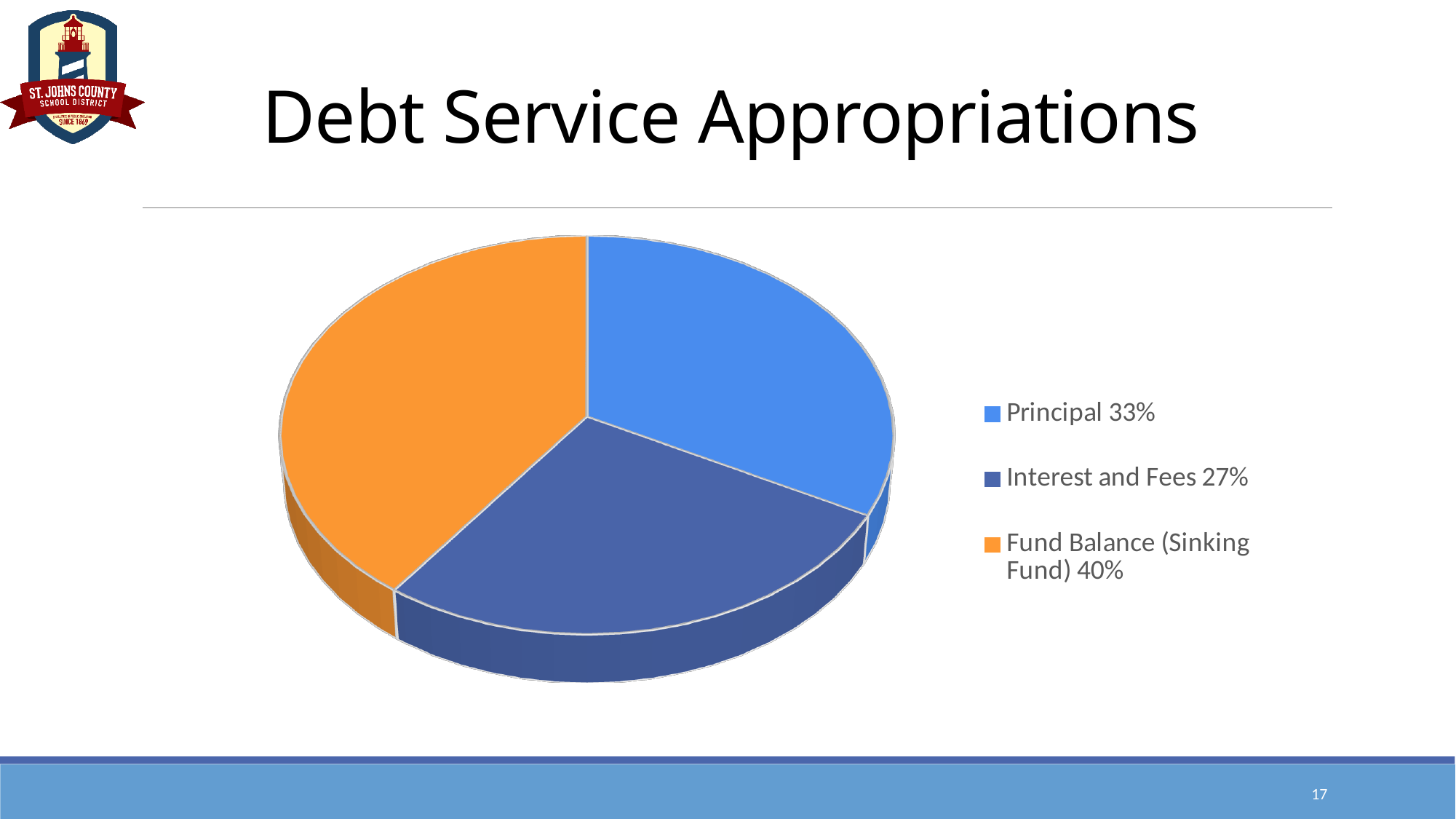
What is the difference in percentage points between Principal and Interest and Fees? 6 Which category has the smallest share of the pie? Interest and Fees What share of the pie is Principal? 33% What share of the pie is Fund Balance (Sinking Fund)? 40% How many categories does the pie chart show? 3 What colour is the Fund Balance (Sinking Fund) slice? Orange Which is larger, the share for Principal or the share for Interest and Fees? Principal What is the difference in percentage points between Fund Balance (Sinking Fund) and Principal? 7 What type of chart is shown on the slide? Pie chart Which category has the largest share of the pie? Fund Balance (Sinking Fund) What is the title of the chart? Debt Service Appropriations What share of the pie is Interest and Fees? 27%